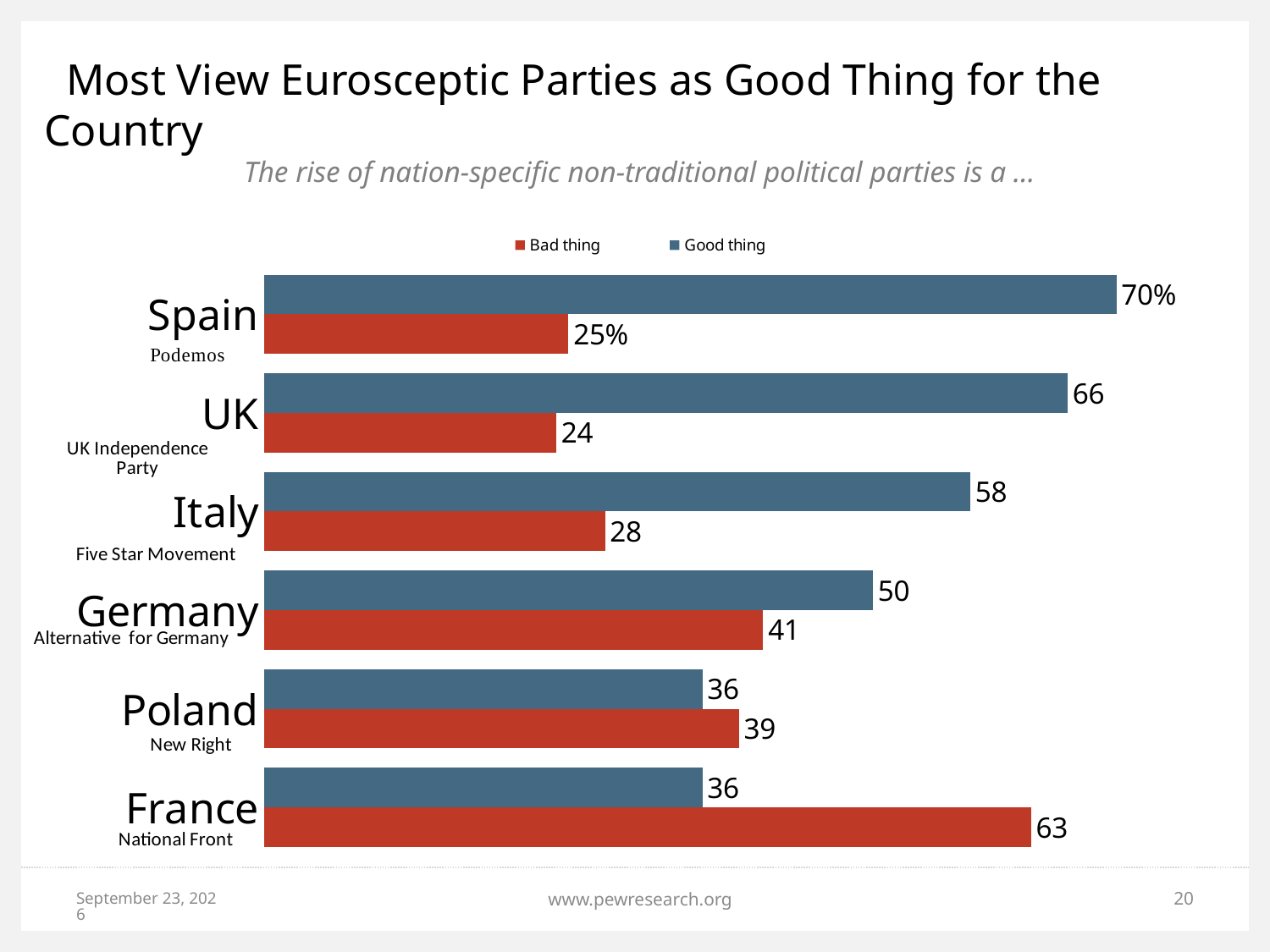
What colour represents the 'Bad thing' series? Red What kind of chart is shown on the slide? Bar chart Which country has the lowest 'Bad thing' value? UK What is the difference between the 'Good thing' and 'Bad thing' values for Italy? 30 For Poland, which is larger: the 'Good thing' value or the 'Bad thing' value? Bad thing Which country has the highest 'Good thing' value? Spain What is the 'Good thing' value for Spain? 70% What is the 'Bad thing' value for Germany? 41 How many countries are shown in the chart? 6 How many series does the legend list? 2 Which party is listed under Italy? Five Star Movement What is the 'Bad thing' value for France? 63